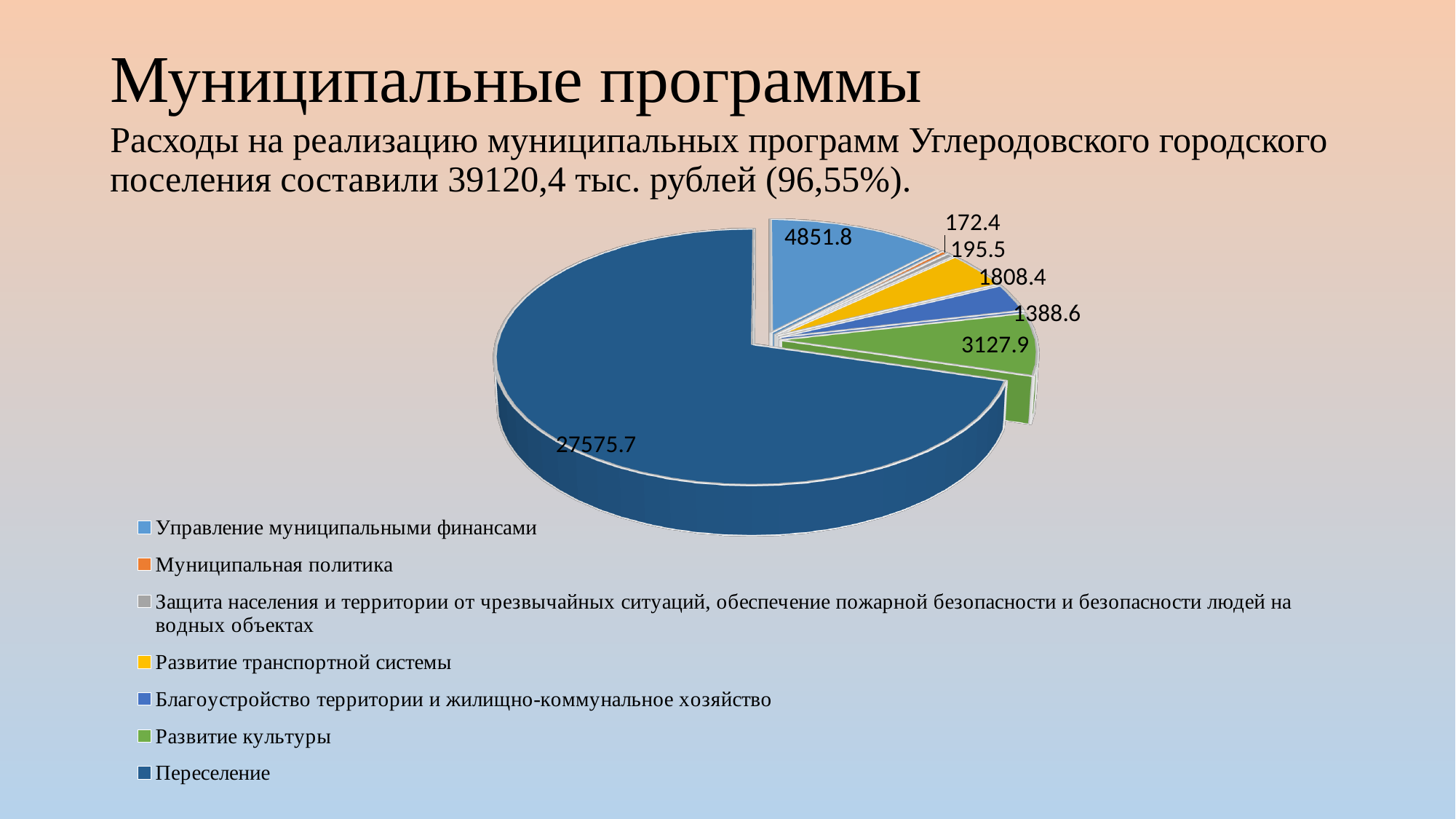
What is the value for Управление муниципальными финансами? 4851.8 What is the value for Развитие культуры? 3127.9 Which category has the smallest value? Муниципальная политика What is the difference between the values for Развитие транспортной системы and Благоустройство территории и жилищно-коммунальное хозяйство? 419.8 What is the value for Развитие транспортной системы? 1808.4 What is the difference between the values for Управление муниципальными финансами and Развитие культуры? 1723.9 What is the value for Переселение? 27575.7 How many categories does the pie chart have? 7 What type of chart is shown on the slide? Pie chart Which is larger: the value for Развитие культуры or the value for Управление муниципальными финансами? Управление муниципальными финансами What is the value for Благоустройство территории и жилищно-коммунальное хозяйство? 1388.6 Which category has the largest slice of the pie? Переселение